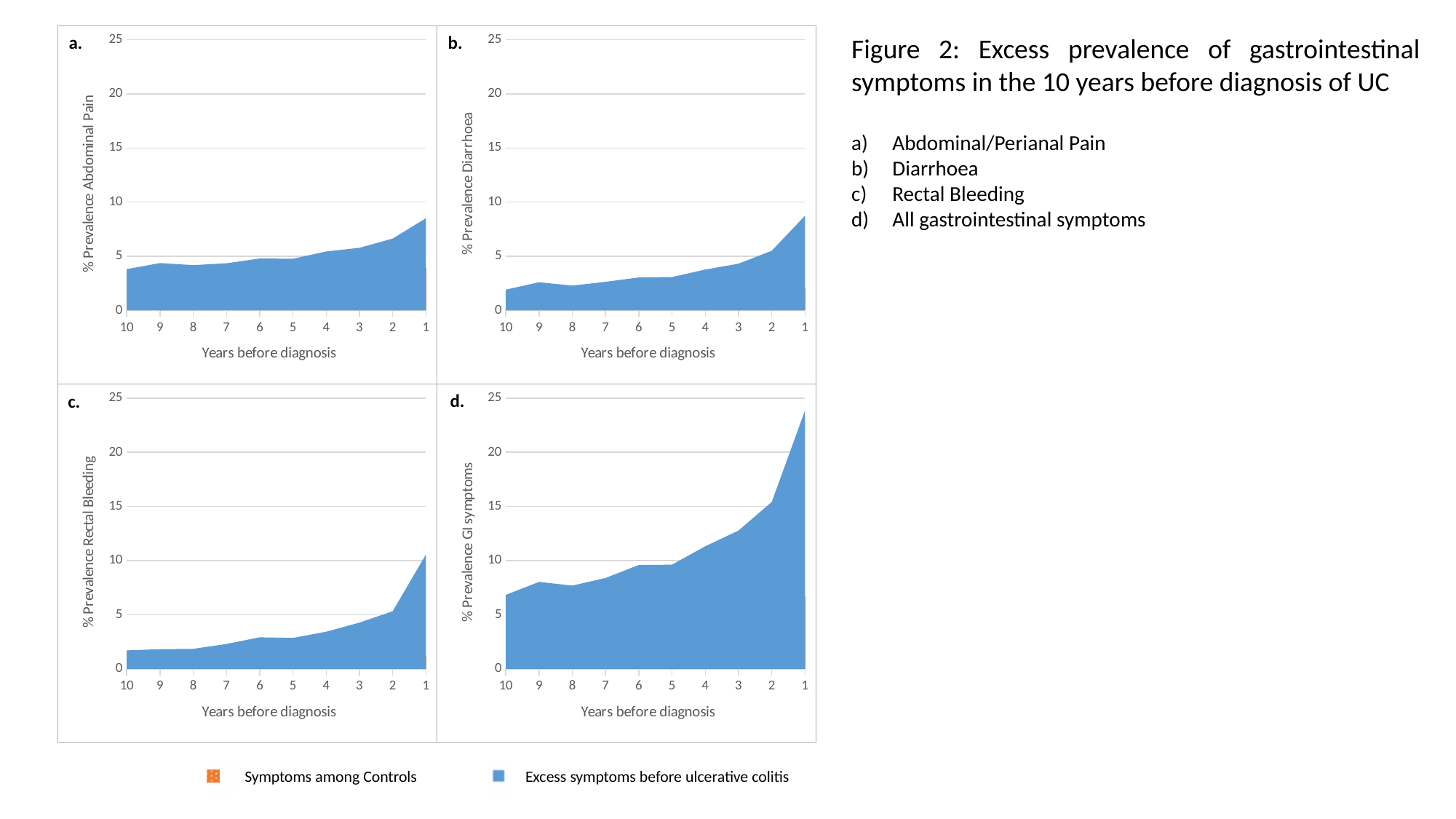
How many series does the legend at the bottom of the slide list? 2 In chart c (% Prevalence Rectal Bleeding), at which number of years before diagnosis is the prevalence highest? 1 In chart a (% Prevalence Abdominal Pain), is the value at 1 year before diagnosis greater or less than 5? greater In chart b (% Prevalence Diarrhoea), does the prevalence rise or fall as the years before diagnosis go from 10 down to 1? rise How many points along the x axis (years before diagnosis) does chart d (GI symptoms) show? 10 In chart d (% Prevalence GI symptoms), which is larger: the value at 1 year before diagnosis or at 10 years before diagnosis? 1 year before diagnosis What does the blue series in the legend represent? Excess symptoms before ulcerative colitis What kind of chart is chart a (Abdominal/Perianal Pain)? area chart In chart d (% Prevalence GI symptoms), is the value at 10 years before diagnosis greater or less than 5? greater In chart b (% Prevalence Diarrhoea), is the value at 10 years before diagnosis greater or less than 5? less